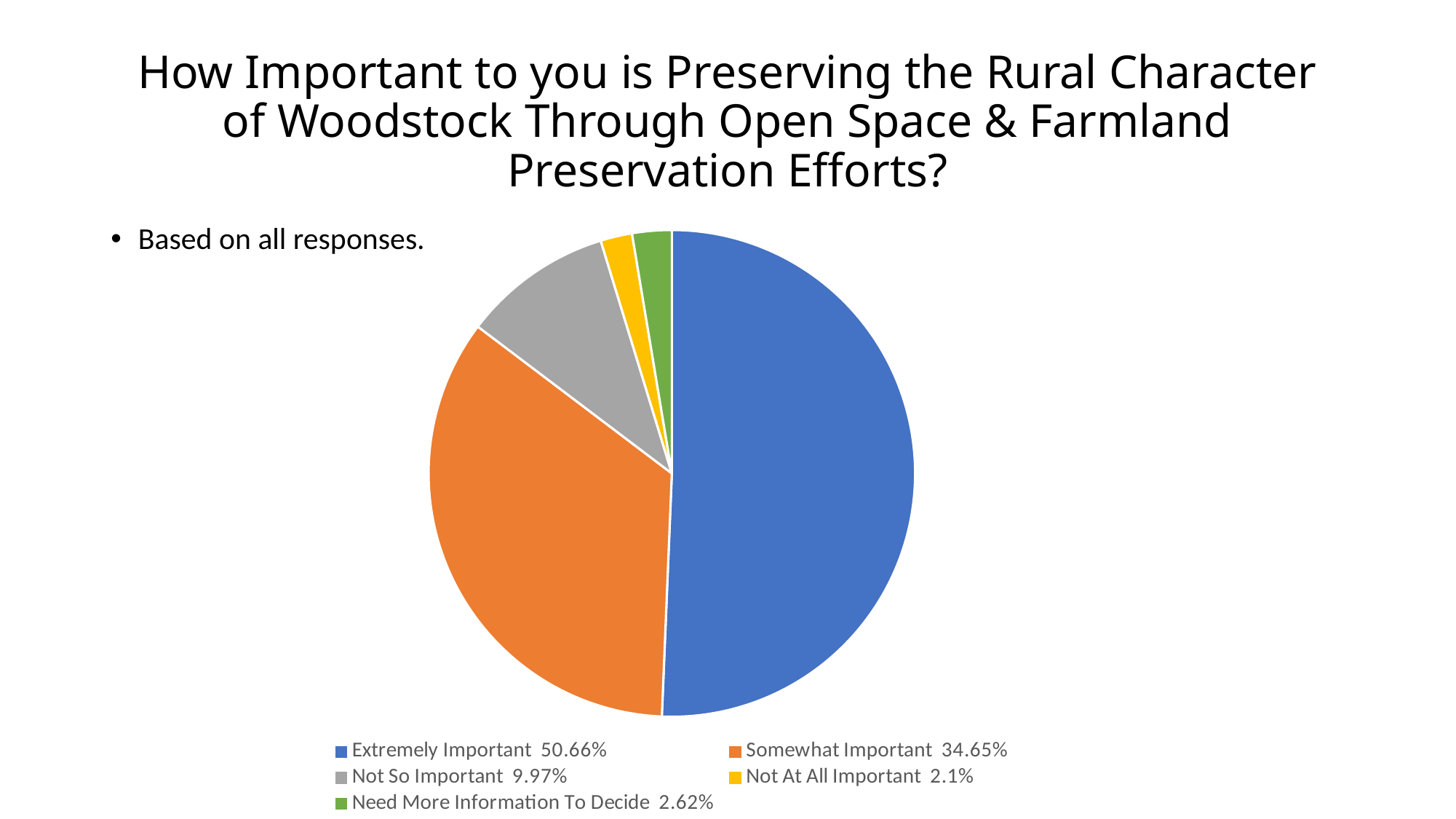
What percentage of responses were "Somewhat Important"? 34.65% What percentage of responses were "Need More Information To Decide"? 2.62% Which response category has the smallest share of the pie? Not At All Important What is the difference in percentage points between "Extremely Important" and "Somewhat Important"? 16.01 How many categories does the pie chart show? 5 What colour is the "Somewhat Important" slice? orange Which is larger, the share for "Not So Important" or the share for "Need More Information To Decide"? Not So Important What kind of chart is shown on the slide? pie chart What percentage of responses were "Not So Important"? 9.97% Which response category has the largest share of the pie? Extremely Important What percentage of responses were "Extremely Important"? 50.66% What percentage of responses were "Not At All Important"? 2.1%